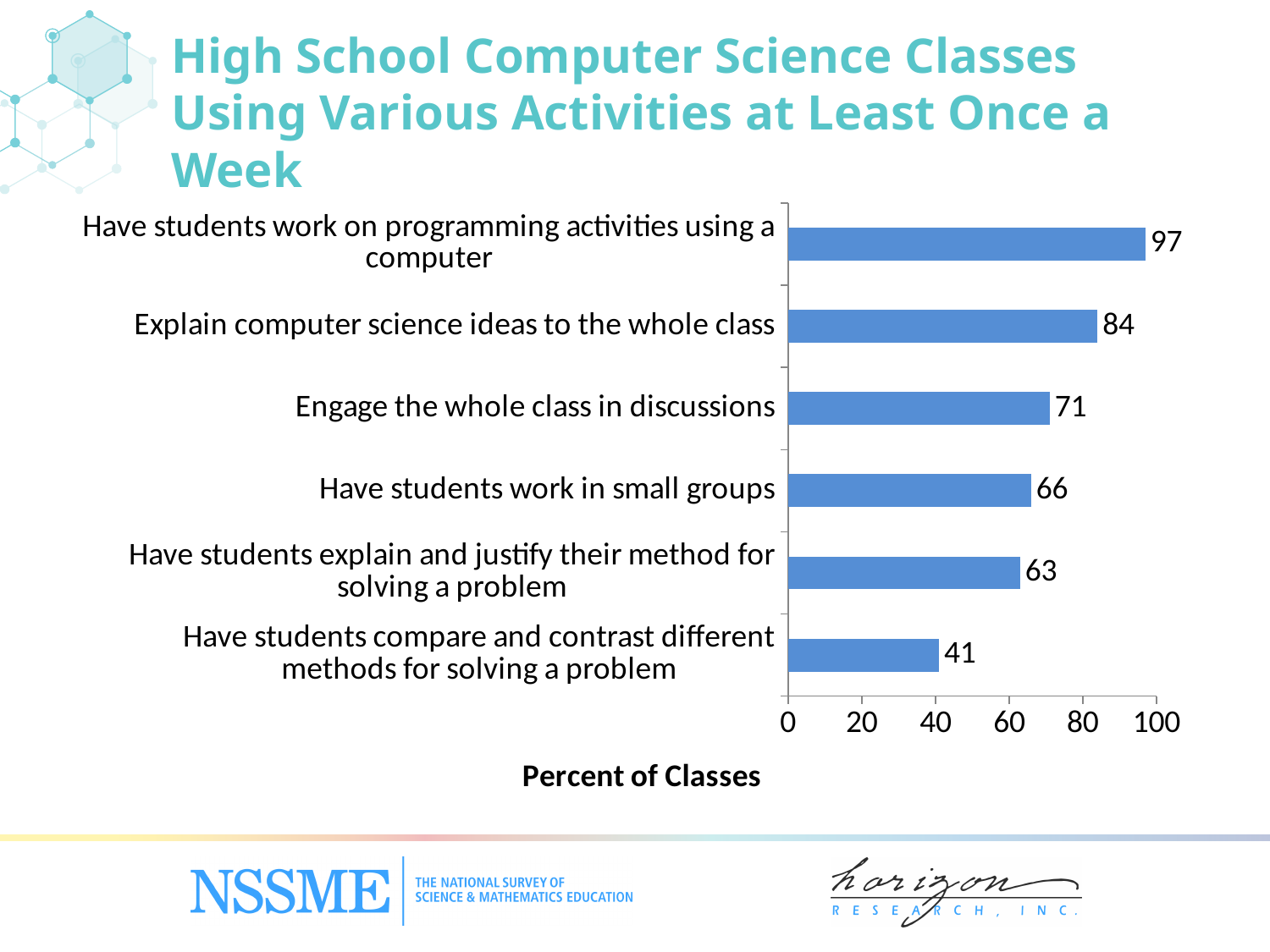
What kind of chart is shown on the slide? bar chart Is the value for 'Engage the whole class in discussions' greater or less than 60? greater What is the difference between the highest and lowest values in the chart? 56 What is the value for 'Engage the whole class in discussions'? 71 How many activities are shown in the chart? 6 What is the difference between the values for 'Explain computer science ideas to the whole class' and 'Have students work in small groups'? 18 What is the label of the horizontal axis? Percent of Classes What is the value for 'Have students compare and contrast different methods for solving a problem'? 41 What percent of classes have students work on programming activities using a computer at least once a week? 97 Which activity has the lowest percent of classes? Have students compare and contrast different methods for solving a problem Which is larger: the value for 'Have students work in small groups' or the value for 'Have students explain and justify their method for solving a problem'? Have students work in small groups Which activity has the highest percent of classes? Have students work on programming activities using a computer